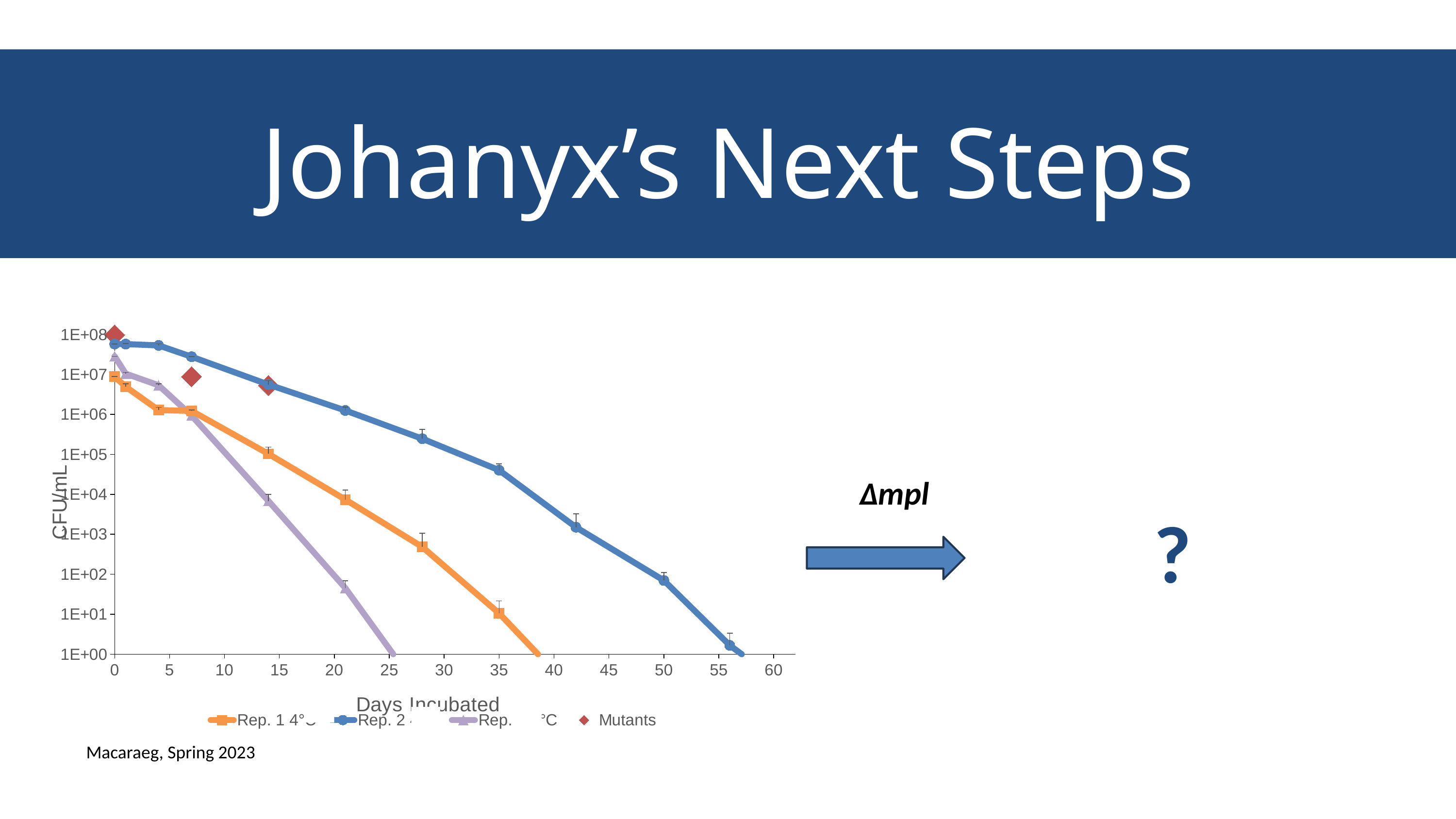
Which series has the highest values across the chart? Rep. 2 Is the value for Mutants at day 7 greater or less than 1E+06? greater Is the value for Rep. 2 at day 28 greater or less than 1E+05? greater What is the label of the x axis of the chart? Days Incubated Is the value for Rep. 2 at day 0 greater or less than 1E+07? greater How many Mutants data points are plotted on the chart? 3 Do the values of the Rep. 2 series rise or fall as Days Incubated increases? Fall What kind of chart is shown on the slide? Line chart What is the label of the y axis of the chart? CFU/mL At day 14, which series has the larger value, Rep. 1 4°C or Rep. 2? Rep. 2 How many series does the chart legend list? 4